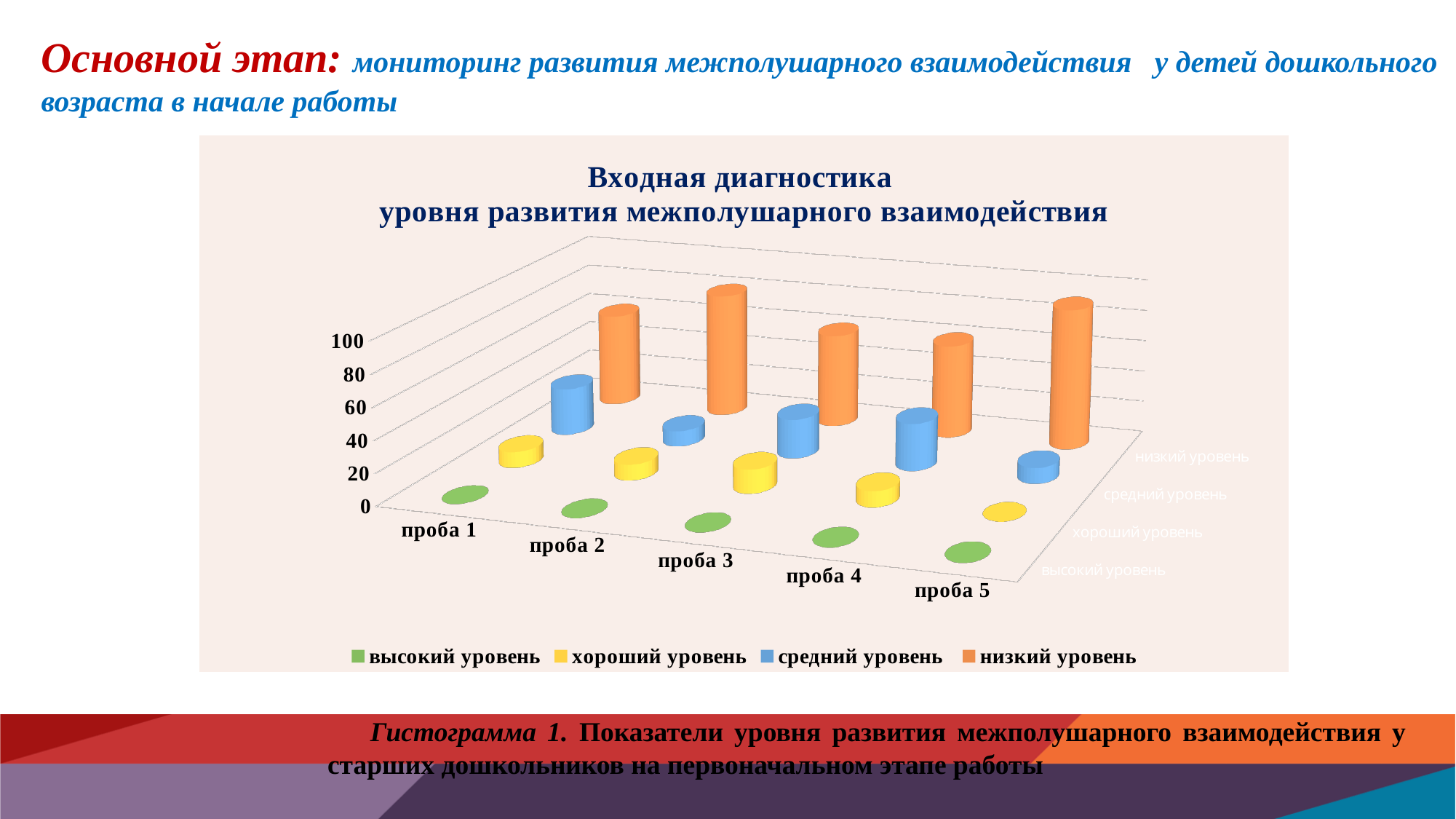
What kind of chart is shown on the slide? bar chart How many categories (пробы) are shown on the x axis of the chart? 5 For проба 3, which is larger: низкий уровень or высокий уровень? низкий уровень Is the value for низкий уровень in проба 5 greater or less than 40? greater Which series has the highest value for проба 5? низкий уровень How many series does the chart legend list? 4 Is the value for хороший уровень in проба 2 greater or less than 40? less Which series has the lowest value for проба 1? высокий уровень Which colour represents the series 'низкий уровень' in the chart? orange What is the title of the chart? Входная диагностика уровня развития межполушарного взаимодействия For проба 1, which is larger: средний уровень or хороший уровень? средний уровень Is the value for высокий уровень in проба 1 greater or less than 20? less